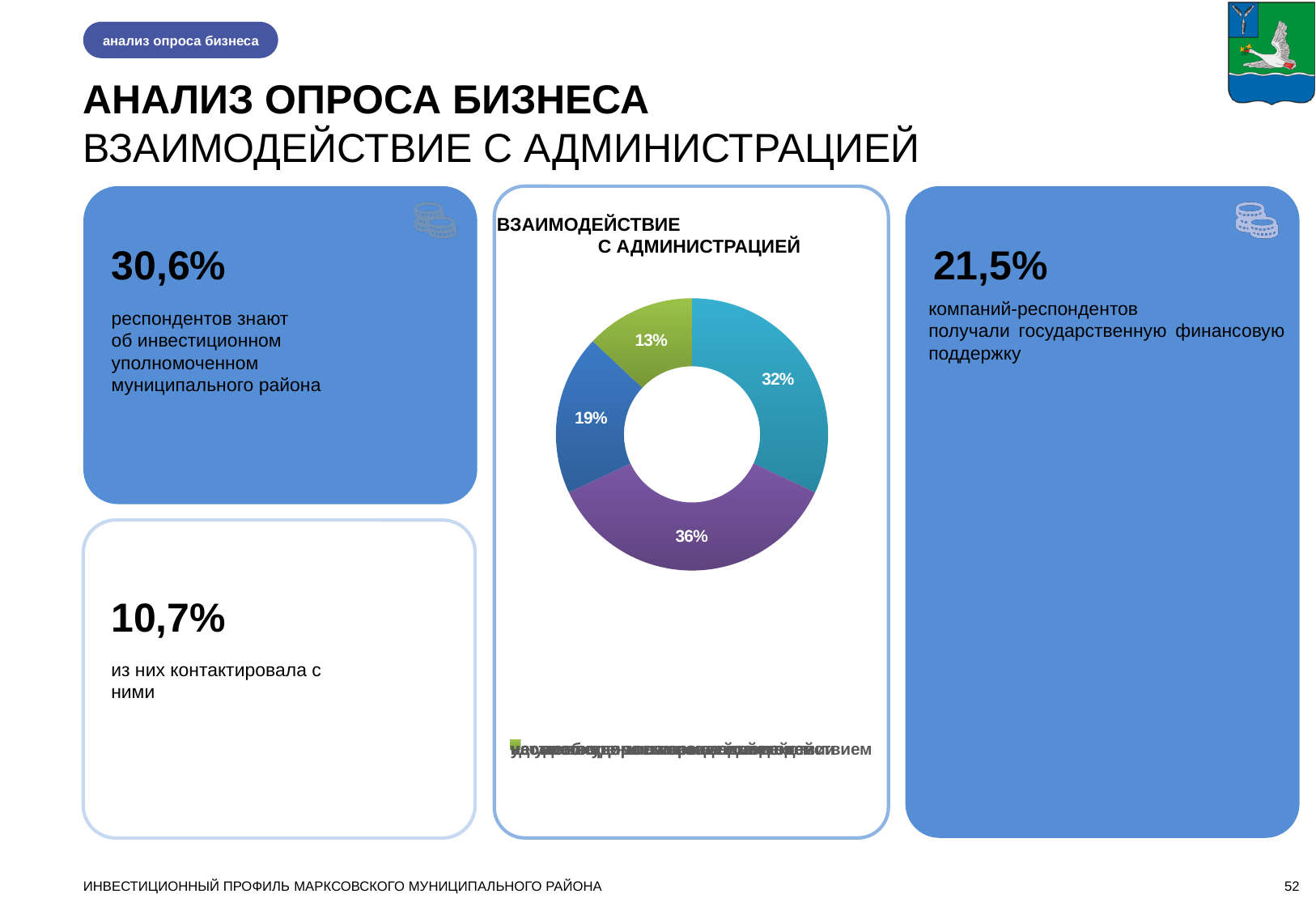
In the donut chart "ВЗАИМОДЕЙСТВИЕ С АДМИНИСТРАЦИЕЙ", what value is shown on the green slice? 13% How many slices does the donut chart "ВЗАИМОДЕЙСТВИЕ С АДМИНИСТРАЦИЕЙ" have? 4 In the donut chart "ВЗАИМОДЕЙСТВИЕ С АДМИНИСТРАЦИЕЙ", what is the value of the largest slice? 36% In the donut chart "ВЗАИМОДЕЙСТВИЕ С АДМИНИСТРАЦИЕЙ", which slice is larger: the teal slice or the dark blue slice? The teal slice (32%) In the donut chart "ВЗАИМОДЕЙСТВИЕ С АДМИНИСТРАЦИЕЙ", what value is shown on the purple slice? 36% In the donut chart "ВЗАИМОДЕЙСТВИЕ С АДМИНИСТРАЦИЕЙ", what do the four slice values (32%, 36%, 19%, 13%) add up to? 100% What kind of chart is shown in the centre of the slide under the title "ВЗАИМОДЕЙСТВИЕ С АДМИНИСТРАЦИЕЙ"? A pie (donut) chart In the donut chart "ВЗАИМОДЕЙСТВИЕ С АДМИНИСТРАЦИЕЙ", what value is shown on the dark blue slice? 19% What is the title of the donut chart in the centre of the slide? ВЗАИМОДЕЙСТВИЕ С АДМИНИСТРАЦИЕЙ In the donut chart "ВЗАИМОДЕЙСТВИЕ С АДМИНИСТРАЦИЕЙ", what value is shown on the teal (light blue) slice? 32% In the donut chart "ВЗАИМОДЕЙСТВИЕ С АДМИНИСТРАЦИЕЙ", what is the value of the smallest slice? 13% In the donut chart "ВЗАИМОДЕЙСТВИЕ С АДМИНИСТРАЦИЕЙ", what is the difference between the largest slice (36%) and the smallest slice (13%)? 23 percentage points